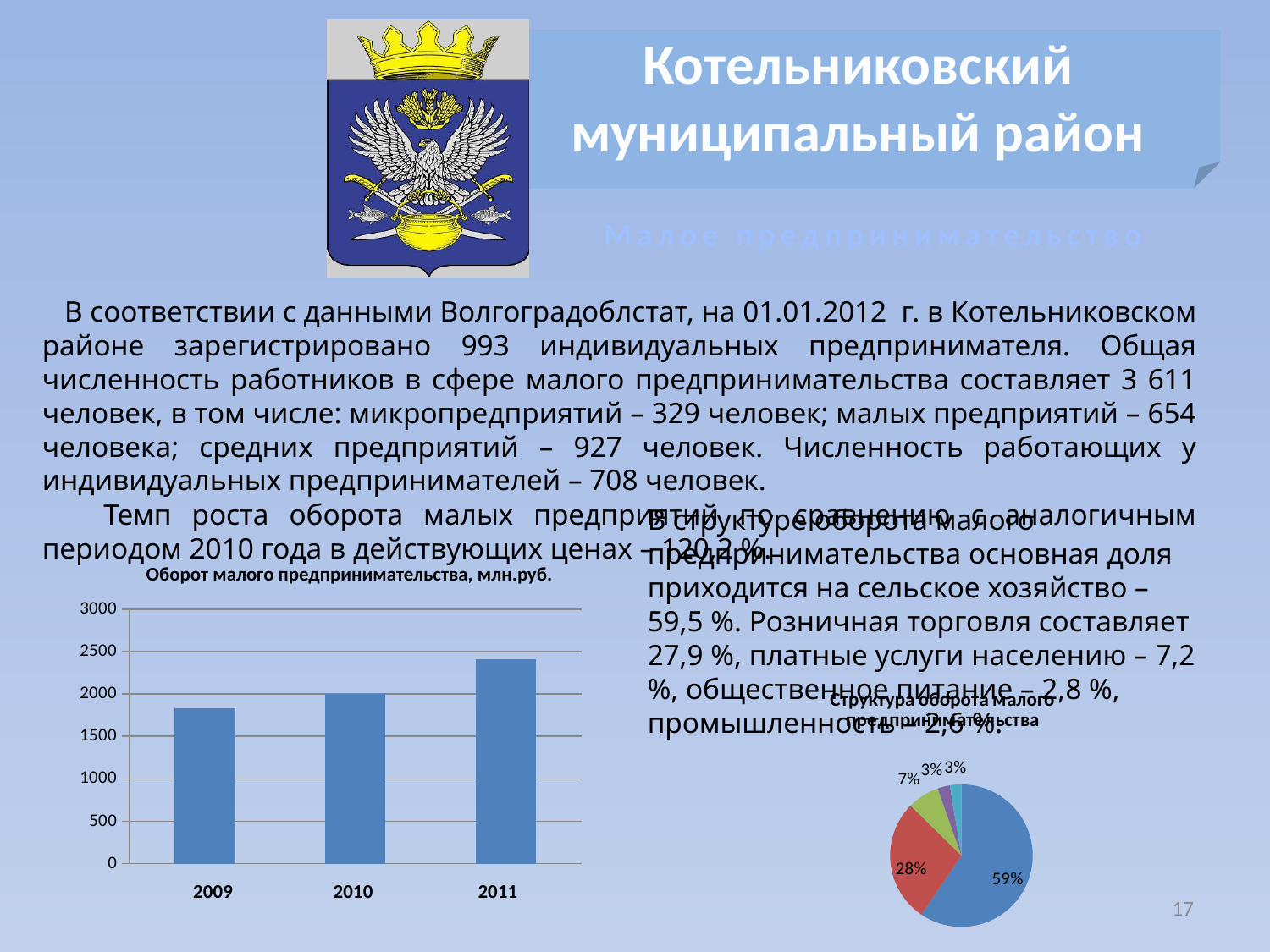
What kind of chart is the chart titled "Структура оборота малого предпринимательства"? pie chart In the chart "Оборот малого предпринимательства, млн.руб.", which is larger, the value for 2010 or the value for 2011? 2011 In the chart "Оборот малого предпринимательства, млн.руб.", do the values rise or fall from 2009 to 2011? rise In the chart "Оборот малого предпринимательства, млн.руб.", how many years are shown on the x axis? 3 In the chart "Оборот малого предпринимательства, млн.руб.", which year has the highest value? 2011 In the chart "Оборот малого предпринимательства, млн.руб.", is the value for 2011 greater or less than 2000? greater What kind of chart is the chart titled "Оборот малого предпринимательства, млн.руб."? bar chart In the chart "Оборот малого предпринимательства, млн.руб.", which year has the lowest value? 2009 In the chart "Оборот малого предпринимательства, млн.руб.", is the value for 2011 greater or less than 2500? less In the chart "Оборот малого предпринимательства, млн.руб.", is the value for 2009 greater or less than 2000? less In the pie chart "Структура оборота малого предпринимательства", how many slices are there? 5 In the pie chart "Структура оборота малого предпринимательства", what is the share of the largest slice? 59%